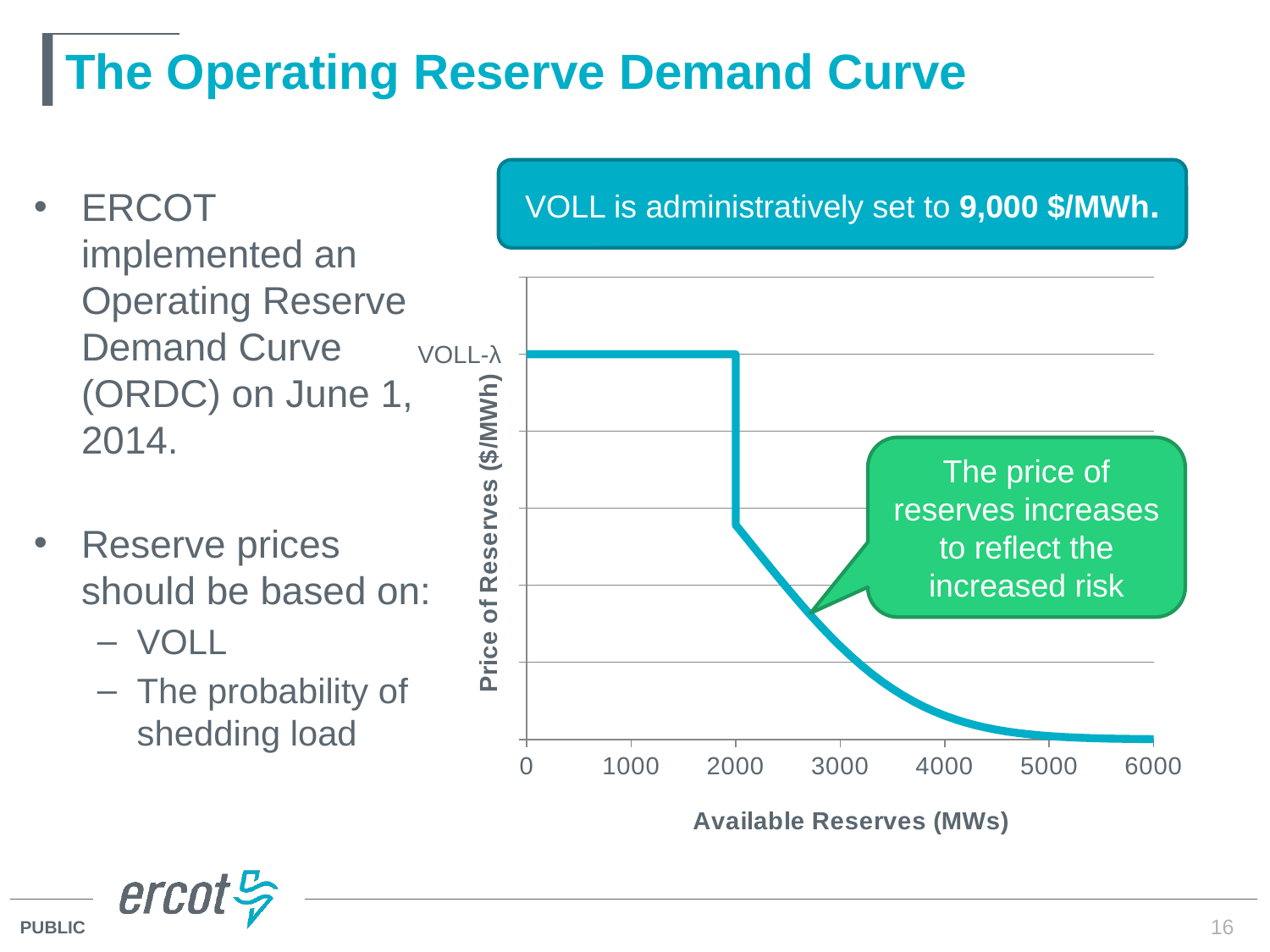
What is the lowest value shown on the x axis of the chart? 0 What is the label of the x axis of the chart? Available Reserves (MWs) What kind of chart is shown on the slide? Line chart At what available reserves value does the curve drop sharply from its flat level? 2000 What is the only value label shown on the y axis of the chart? VOLL-λ What is the label of the y axis of the chart? Price of Reserves ($/MWh) Is the price of reserves at 5000 MW greater or less than the price at 2500 MW? less Which is larger, the price of reserves at 3000 MW or at 5000 MW of available reserves? 3000 MW What is the highest value shown on the x axis of the chart? 6000 Does the price of reserves rise or fall as available reserves increase beyond 2000 MW? Fall Which is larger, the price of reserves at 1000 MW or at 4000 MW of available reserves? 1000 MW How many tick labels are shown on the x axis of the chart? 7